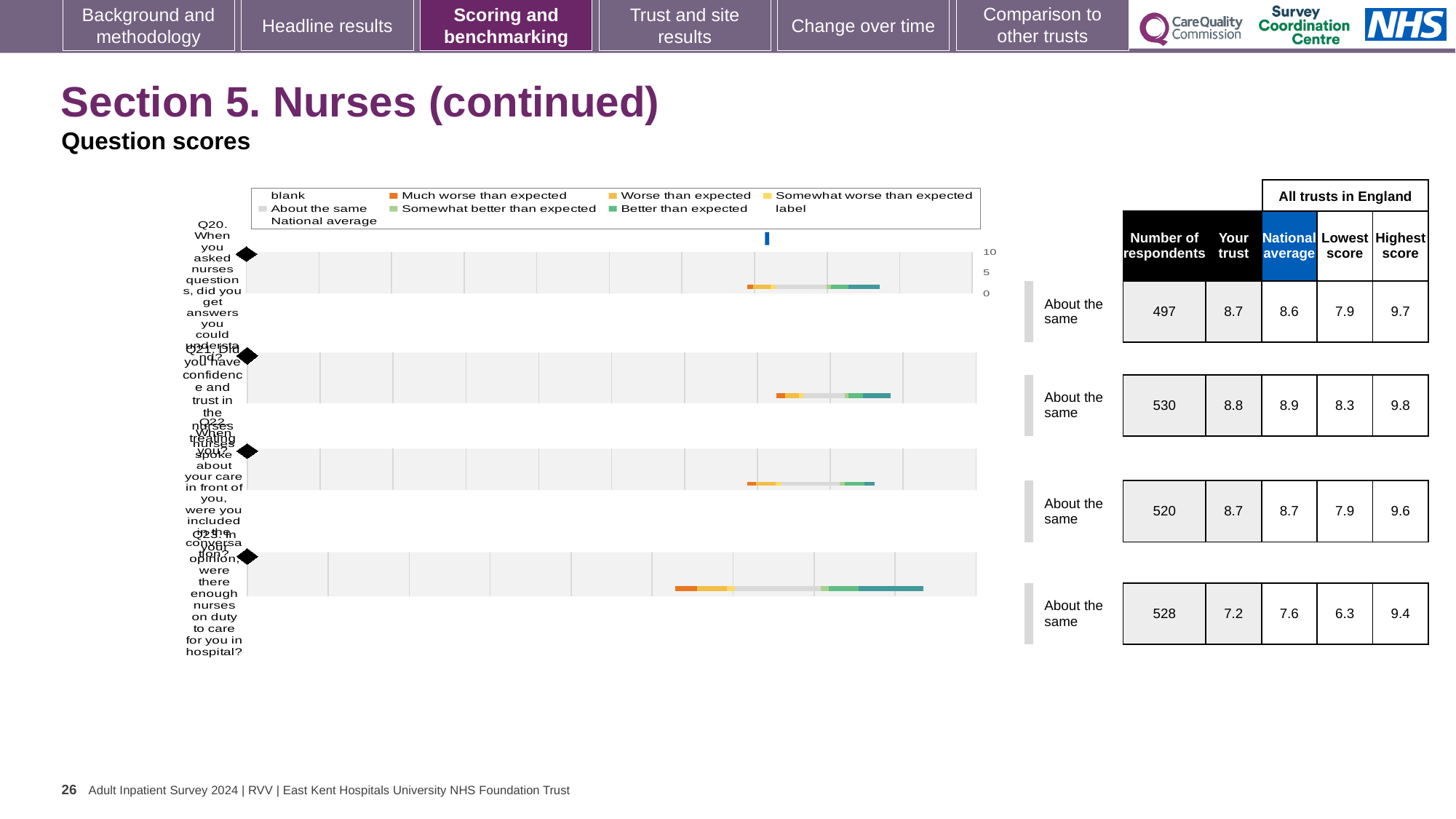
Which question has the highest 'Your trust' score? Q21 What benchmark category is shown for Q22? About the same What is the national average for Q23? 7.6 Which question has the lowest 'Your trust' score? Q23 What is the difference between the highest score and the lowest score for Q23? 3.1 What is the lowest score among all trusts in England for Q22? 7.9 What is the highest score among all trusts in England for Q20? 9.7 What is the 'Your trust' score for Q21? 8.8 For Q21, which is larger: the 'Your trust' score or the national average? National average How many questions (categories) are plotted in the chart? 4 What kind of chart is shown on the slide? bar chart What is the number of respondents for Q20? 497